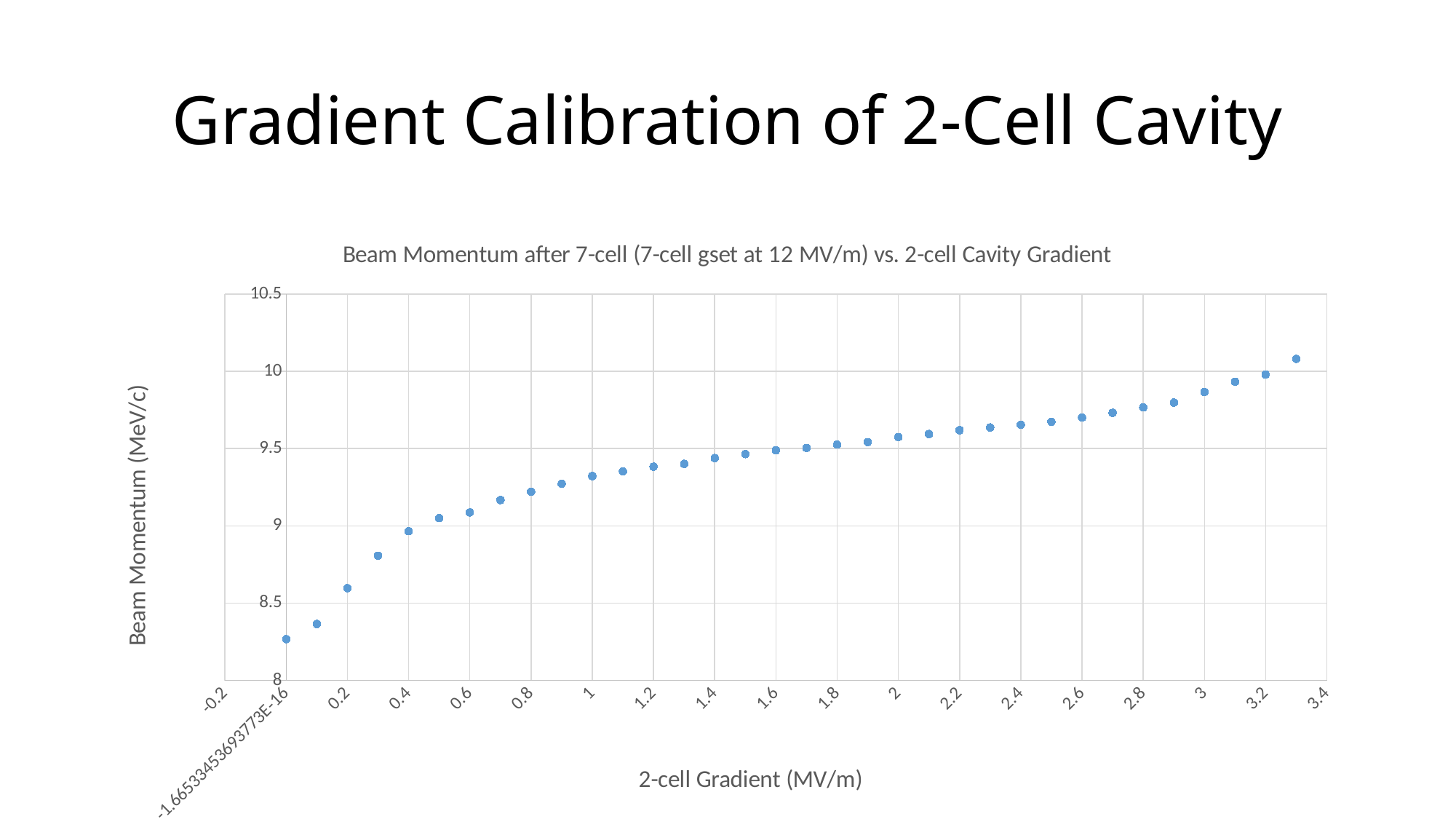
What is the title of the chart? Beam Momentum after 7-cell (7-cell gset at 12 MV/m) vs. 2-cell Cavity Gradient Is the beam momentum at a 2-cell gradient of 0.2 greater or less than 9? less Does beam momentum rise or fall as the 2-cell gradient increases along the x axis? rise What is the label of the y axis? Beam Momentum (MeV/c) Which has the larger beam momentum: a 2-cell gradient of 0.4 or a 2-cell gradient of 2.4? 2.4 Is the beam momentum at a 2-cell gradient of 0.1 greater or less than 8.5? less Is the beam momentum at a 2-cell gradient of 3.3 greater or less than 10? greater What kind of chart is shown on the slide? scatter chart